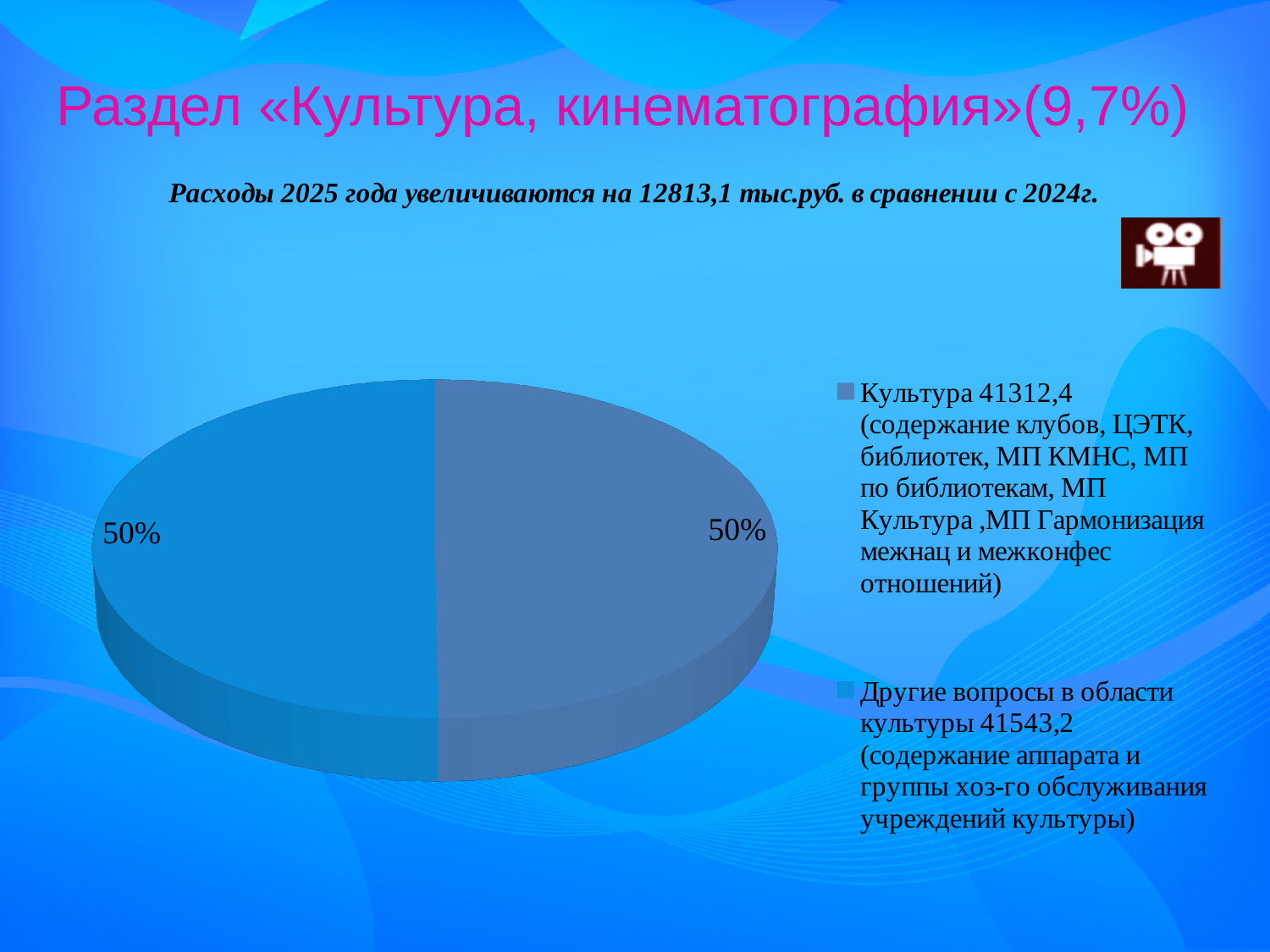
What share of the pie does the slice for «Культура» represent? 50% What amount is given in the legend for «Культура»? 41312,4 By how much do the 2025 expenses increase compared with 2024, according to the text above the chart? 12813,1 тыс.руб. According to the legend amounts, which is larger: «Культура» or «Другие вопросы в области культуры»? Другие вопросы в области культуры What share of the pie does the slice for «Другие вопросы в области культуры» represent? 50% What is the difference between the legend amounts for «Другие вопросы в области культуры» (41543,2) and «Культура» (41312,4)? 230,8 How many entries does the legend of the pie chart list? 2 What kind of chart is shown on the slide? pie chart What amount is given in the legend for «Другие вопросы в области культуры»? 41543,2 What percentage is shown in the slide title for the section «Культура, кинематография»? 9,7% How many slices does the pie chart have? 2